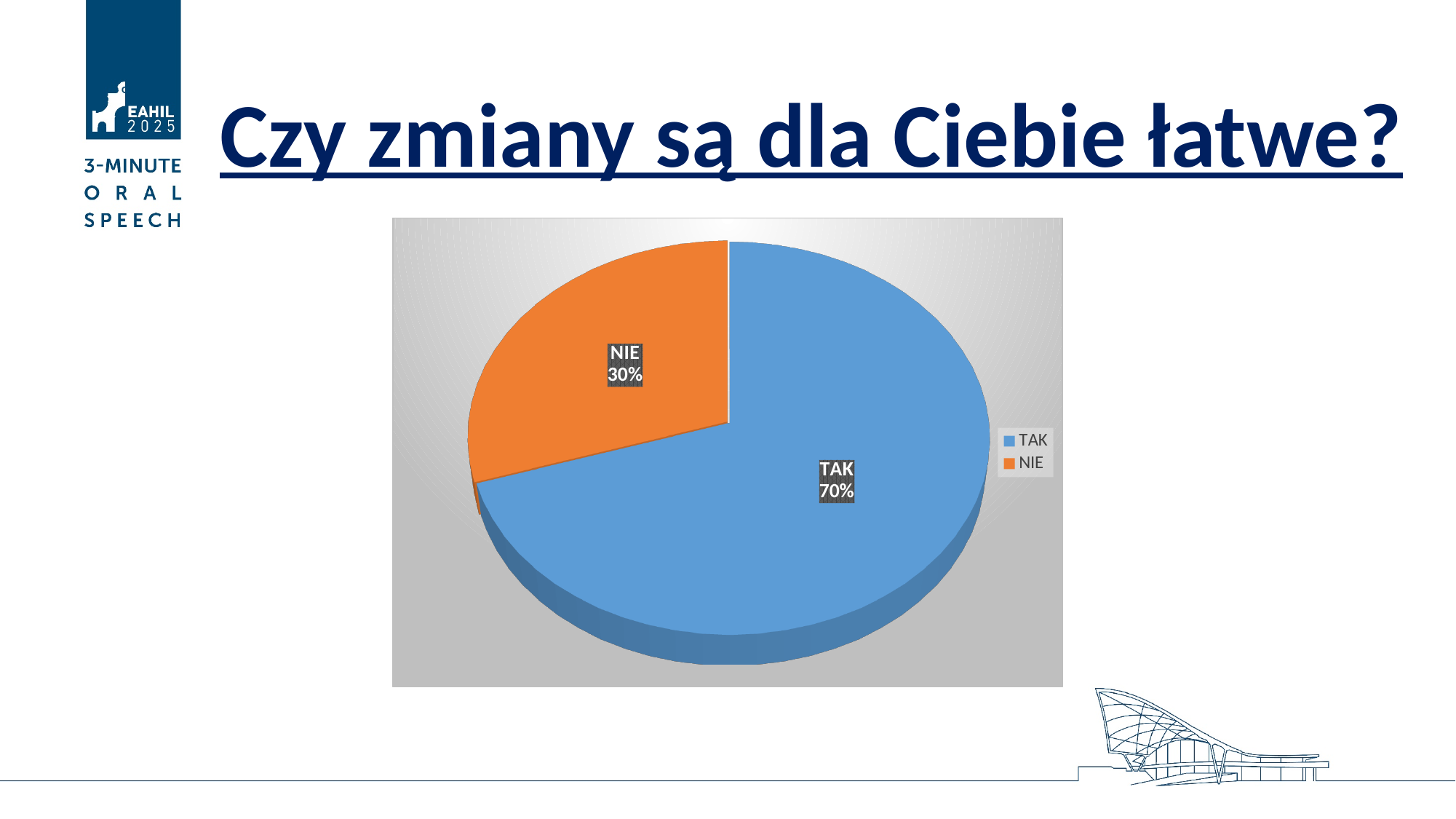
What kind of chart is shown on the slide? Pie chart How many entries does the legend list? 2 What is the difference in percentage points between the TAK and NIE slices? 40 What percentage of the pie chart is labelled TAK? 70% Which slice is larger, TAK or NIE? TAK How many slices does the pie chart have? 2 Which slice of the pie chart is the largest? TAK What percentage of the pie chart is labelled NIE? 30% What is the title of the slide above the chart? Czy zmiany są dla Ciebie łatwe? Which slice of the pie chart is the smallest? NIE What share of the pie does the NIE slice represent? 30% What colour is the TAK slice in the pie chart? Blue